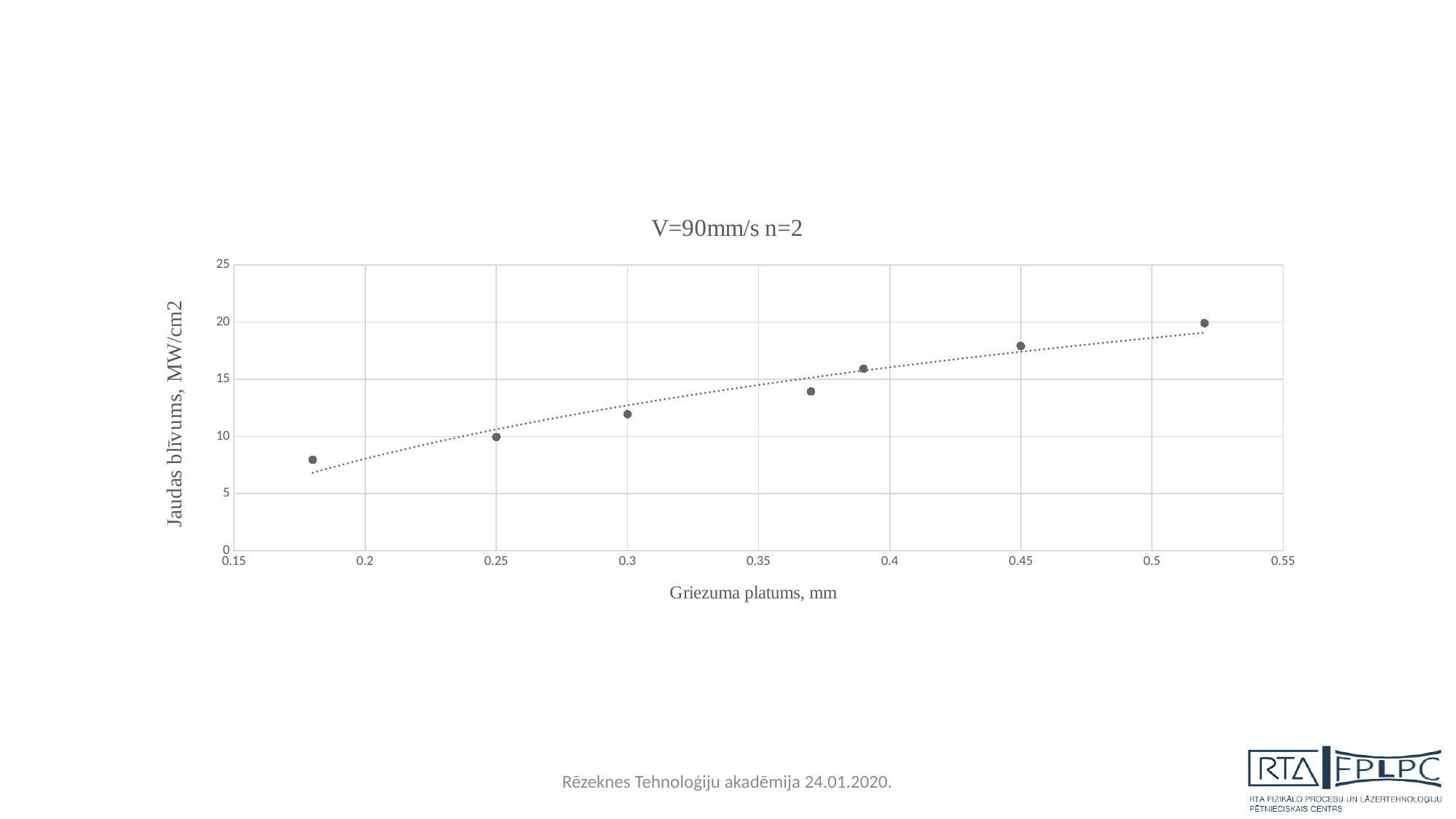
Is the value for the point at 0.37 mm greater or less than 15? less Is the value for the point at 0.18 mm greater or less than 10? less At which cut width is the plotted power density lowest? 0.18 mm How many data points are plotted on the chart? 7 Is the value for the point at 0.45 mm greater or less than 20? less What kind of chart is shown on the slide? scatter chart Do the values rise or fall as the cut width (Griezuma platums) increases along the x axis? rise Which point has the highest power density: the one at 0.18 mm or the one at 0.52 mm? 0.52 mm What is the title of the chart? V=90mm/s n=2 What is the label of the x axis? Griezuma platums, mm